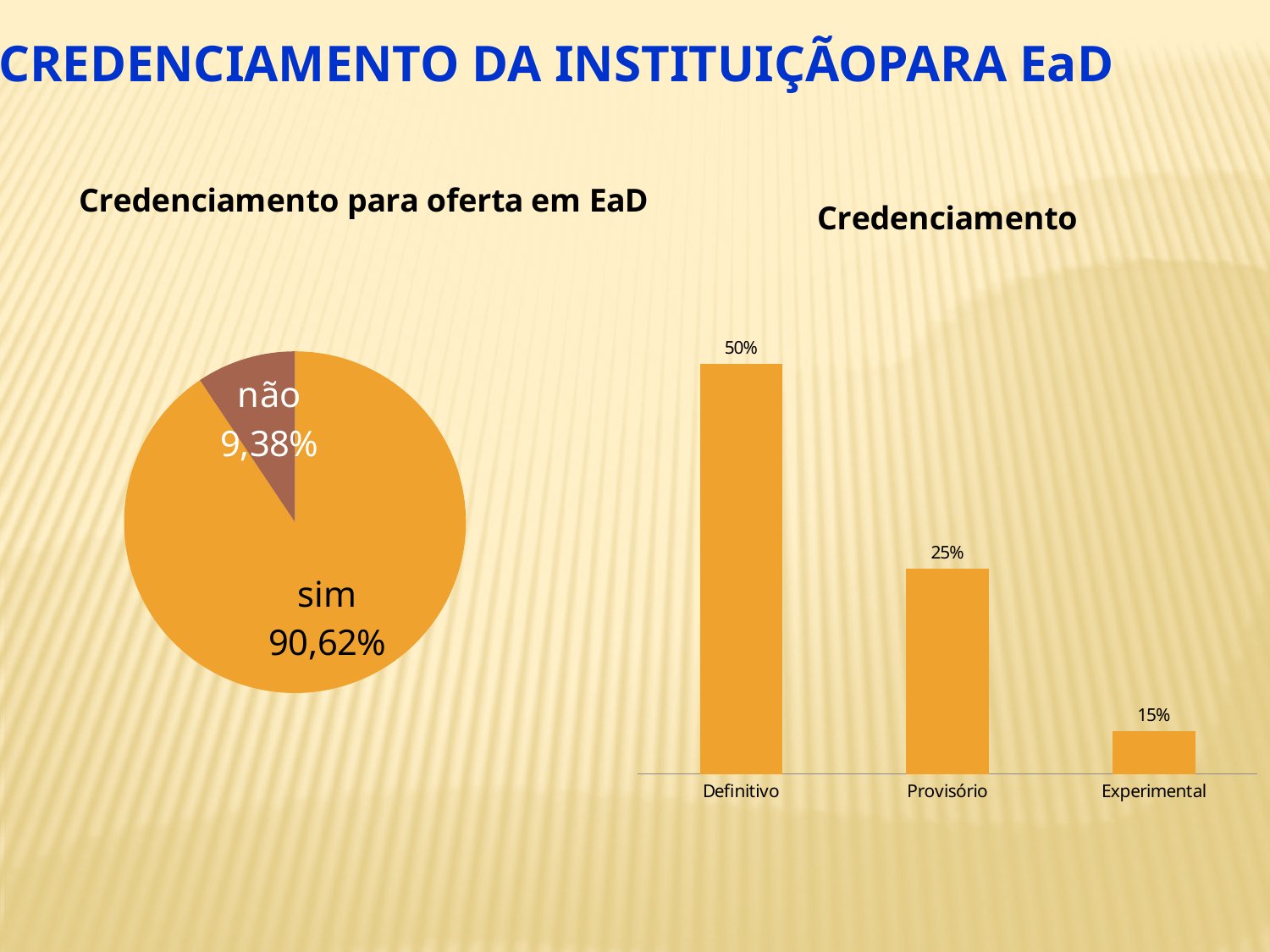
What kind of chart is 'Credenciamento'? Bar chart In the 'Credenciamento' chart, which category has the lowest value? Experimental In the 'Credenciamento para oferta em EaD' chart, what share does 'sim' have? 90,62% In the 'Credenciamento' chart, what is the value for Provisório? 25% In the 'Credenciamento' chart, what is the value for Definitivo? 50% How many slices does the 'Credenciamento para oferta em EaD' pie chart have? 2 In the 'Credenciamento' chart, what is the difference between Definitivo and Provisório? 25% In the 'Credenciamento para oferta em EaD' chart, which slice is the largest? sim In the 'Credenciamento' chart, what is the value for Experimental? 15% In the 'Credenciamento para oferta em EaD' chart, what share does 'não' have? 9,38% What kind of chart is 'Credenciamento para oferta em EaD'? Pie chart In the 'Credenciamento' chart, which is larger, Provisório or Experimental? Provisório